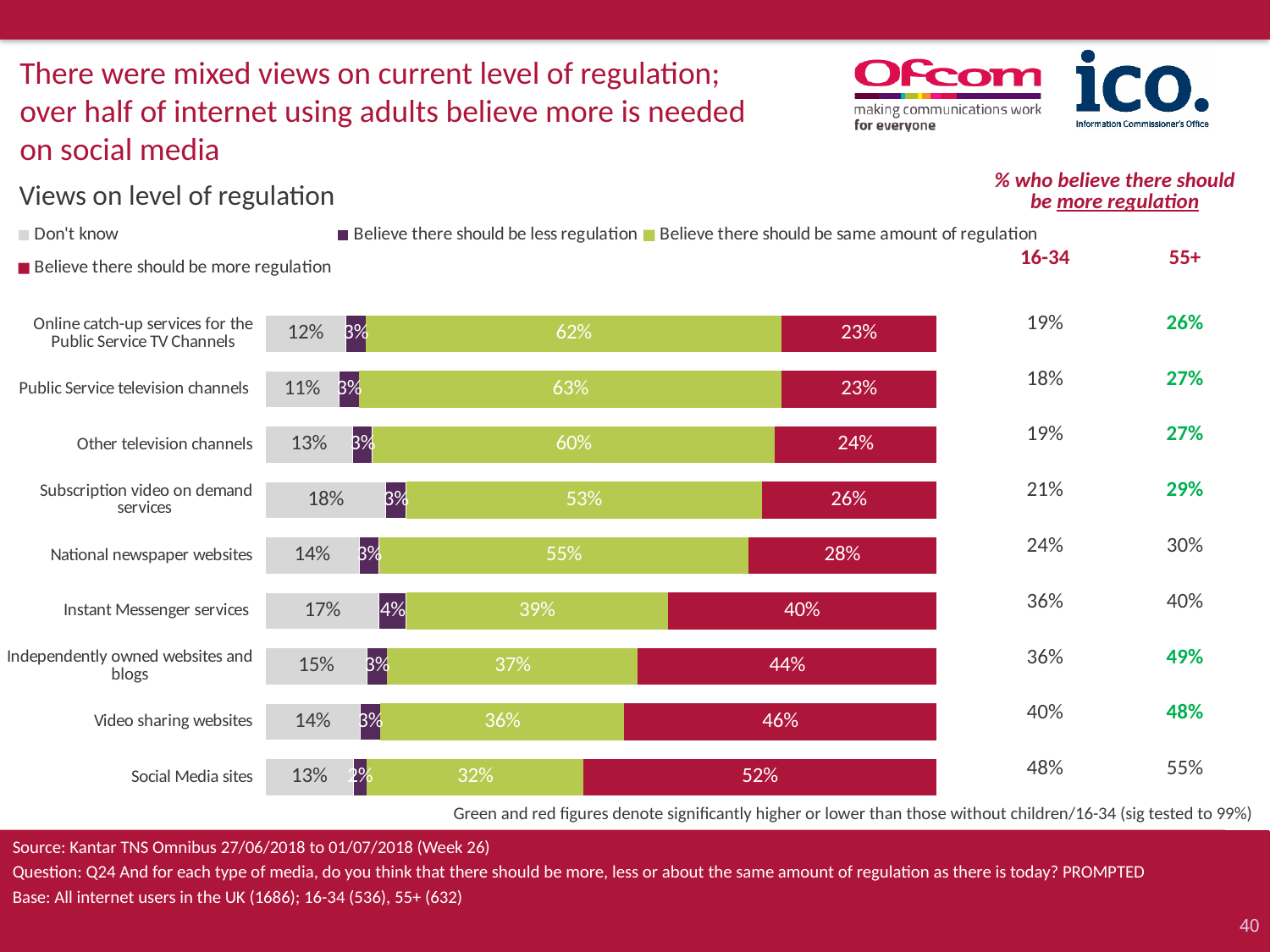
Which category has the lowest percentage believing there should be the same amount of regulation? Social Media sites How many series does the chart legend list? 4 What is the difference in the 'more regulation' percentage between Video sharing websites and Instant Messenger services? 6 percentage points What type of chart is used to show views on level of regulation? Stacked bar chart What is the 'Don't know' percentage for Subscription video on demand services? 18% How many media categories are shown in the chart? 9 What percentage believe there should be more regulation of Social Media sites? 52% What percentage believe there should be less regulation of Instant Messenger services? 4% What percentage believe there should be the same amount of regulation for Public Service television channels? 63% Which colour represents 'Believe there should be more regulation' in the chart? Red Which has a higher 'same amount of regulation' percentage: Other television channels or National newspaper websites? Other television channels Which category has the highest percentage believing there should be more regulation? Social Media sites